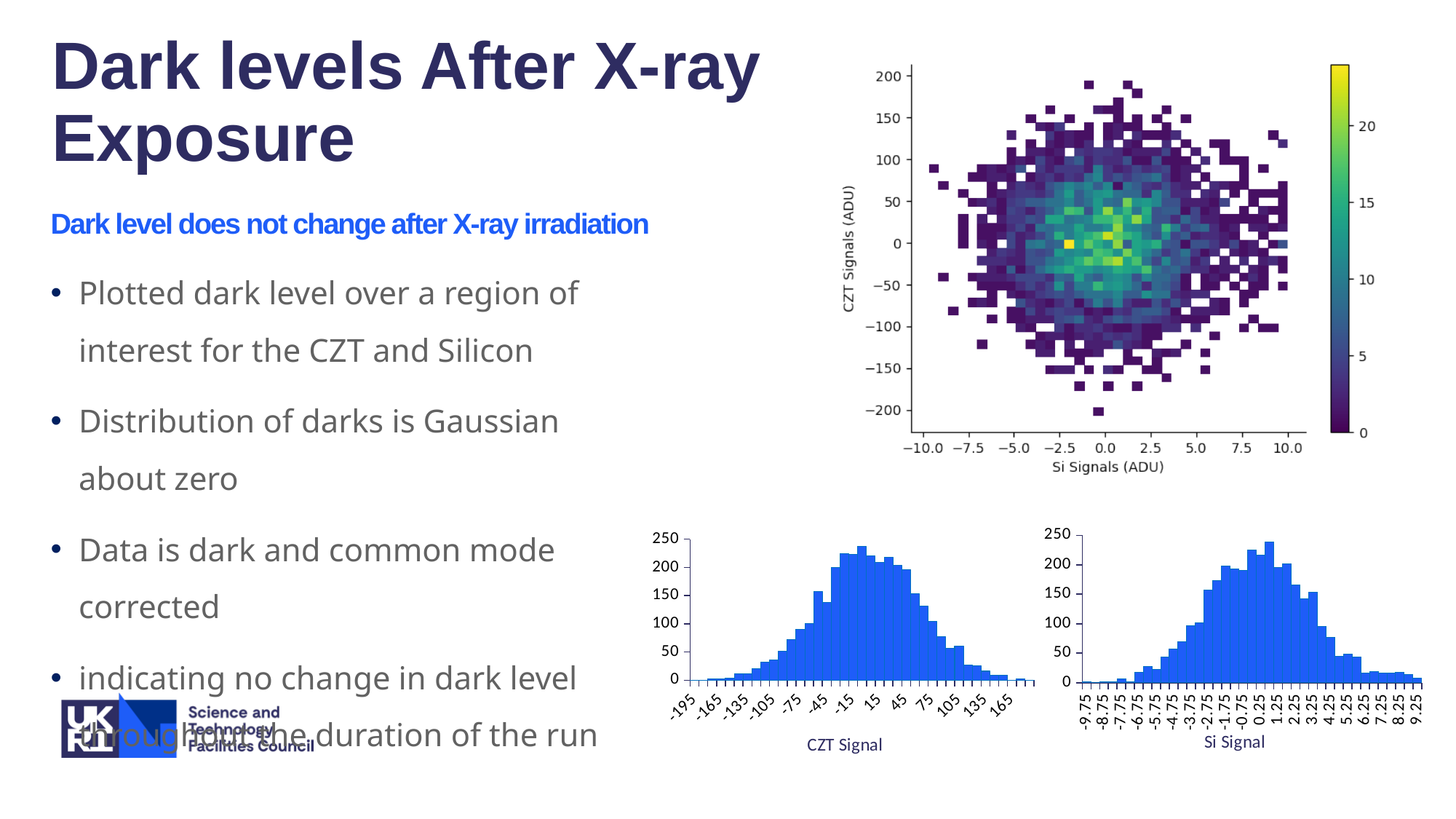
In the top-right chart, what is the label on the y axis? CZT Signals (ADU) In the "CZT Signal" chart, do the bar heights rise or fall from -195 to -15 along the x axis? rise In the top-right chart, what is the label on the x axis? Si Signals (ADU) In the "CZT Signal" chart, is the value for 165 greater or less than 50? less What kind of chart is the bottom-left chart titled "CZT Signal"? bar chart In the "Si Signal" chart, is the tallest bar greater or less than 200? greater In the "Si Signal" chart, is the value for -3.75 greater or less than 50? greater What kind of chart is the bottom-right chart titled "Si Signal"? bar chart In the "Si Signal" chart, do the bar heights rise or fall from 1.25 to 9.25 along the x axis? fall